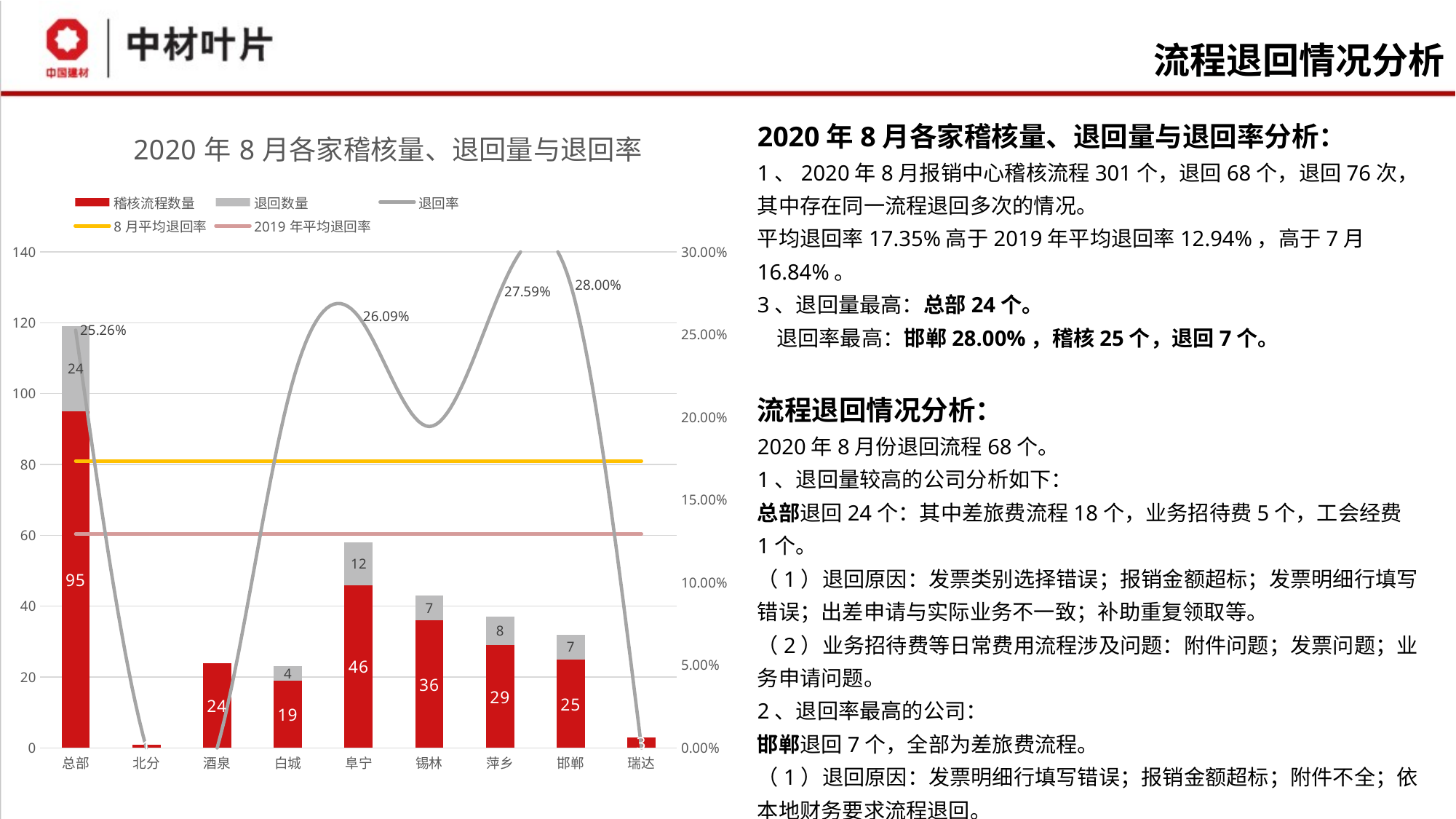
Which category has the highest labelled 退回率? 邯郸 How many categories are shown on the x axis? 9 What is the total of the stacked bar for 总部 (稽核流程数量 plus 退回数量)? 119 Is the 8月平均退回率 line greater or less than 15.00%? greater Which has a larger 稽核流程数量, 锡林 or 萍乡? 锡林 What is the 退回率 value labelled for 邯郸? 28.00% How many series does the legend list? 5 Which category has the highest 稽核流程数量? 总部 What is the difference between the 稽核流程数量 of 总部 and 阜宁? 49 What is the title of the chart? 2020年8月各家稽核量、退回量与退回率 What is the 退回数量 value for 阜宁? 12 What is the 稽核流程数量 value for 总部? 95